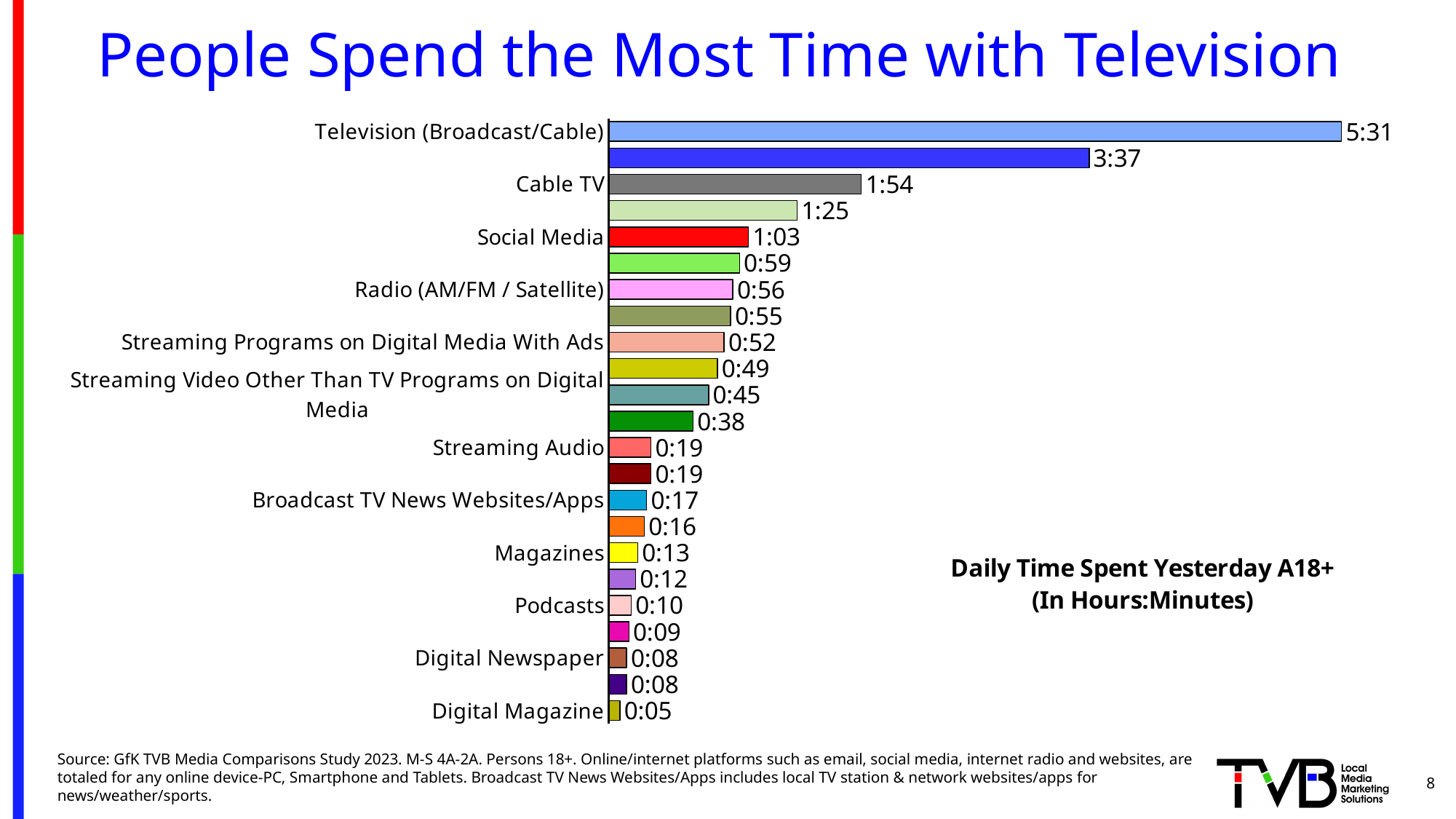
Which has a larger daily time spent, Social Media or Radio (AM/FM / Satellite)? Social Media Which category has the lowest daily time spent? Digital Magazine What is the daily time spent with Social Media? 1:03 How many bars are plotted in the chart? 23 What type of chart is shown on the slide? Bar chart Which category has the highest daily time spent? Television (Broadcast/Cable) What is the daily time spent with Radio (AM/FM / Satellite)? 0:56 What is the daily time spent with Television (Broadcast/Cable)? 5:31 What is the daily time spent with Digital Magazine? 0:05 Which has a larger daily time spent, Magazines or Podcasts? Magazines What is the difference in daily time spent between Television (Broadcast/Cable) and Cable TV? 3:37 What is the daily time spent with Cable TV? 1:54